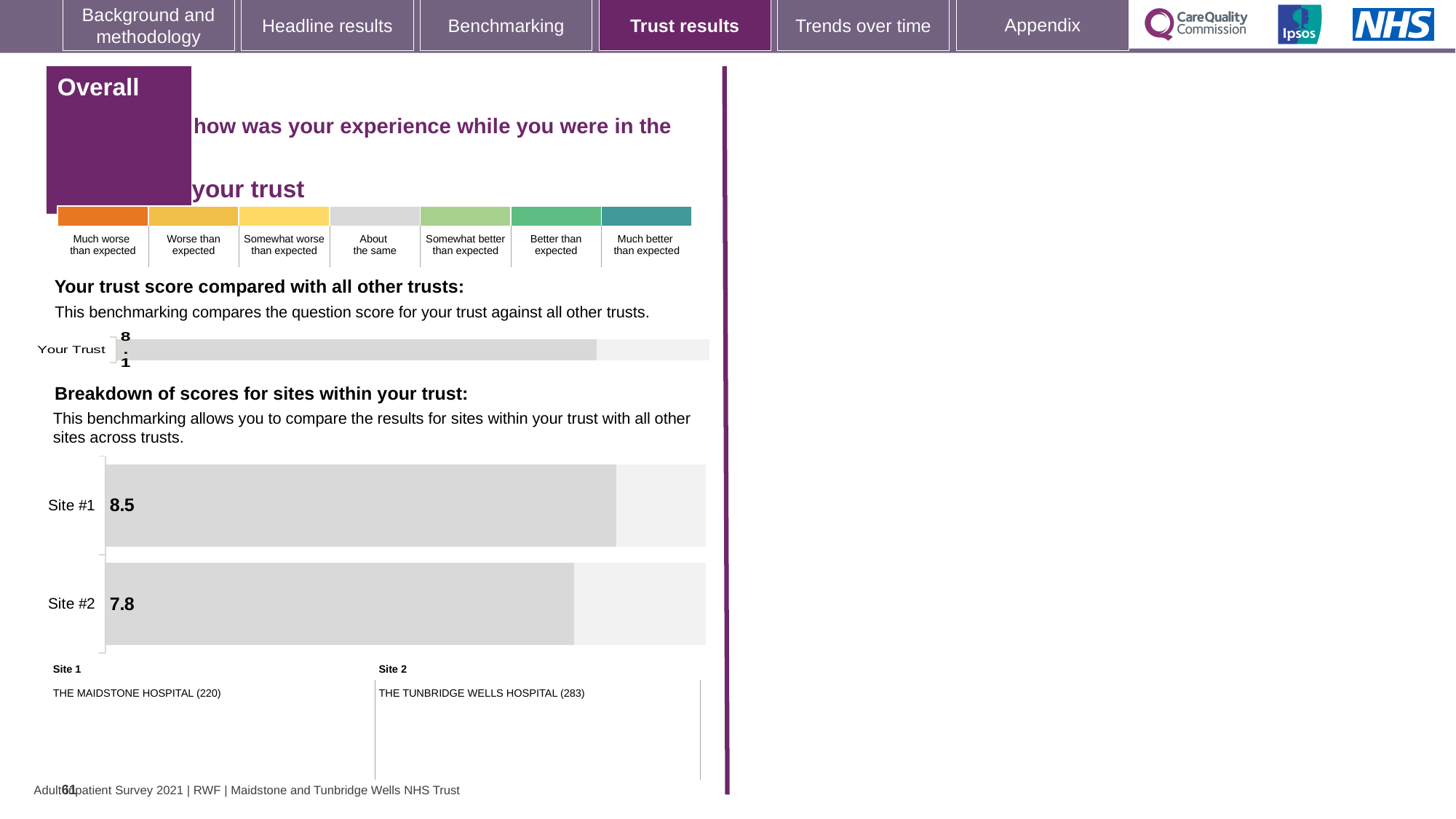
How many sites are shown in the 'Breakdown of scores for sites within your trust' chart? 2 Is the Your Trust score in the 'Your trust score compared with all other trusts' chart larger or smaller than the Site #2 score in the breakdown chart? larger In the 'Breakdown of scores for sites within your trust' chart, what is the score for Site #2? 7.8 What kind of chart is the 'Your trust score compared with all other trusts' chart? bar chart In the 'Breakdown of scores for sites within your trust' chart, what is the difference between the scores for Site #1 and Site #2? 0.7 In the 'Breakdown of scores for sites within your trust' chart, what is the score for Site #1? 8.5 What kind of chart is the 'Breakdown of scores for sites within your trust' chart? bar chart In the 'Breakdown of scores for sites within your trust' chart, is the score for Site #1 larger or smaller than the score for Site #2? larger In the 'Breakdown of scores for sites within your trust' chart, which site has the highest score? Site #1 In the 'Breakdown of scores for sites within your trust' chart, which site has the lowest score? Site #2 According to the slide, which hospital is Site 1? THE MAIDSTONE HOSPITAL (220) In the 'Your trust score compared with all other trusts' chart, what is the score for Your Trust? 8.1